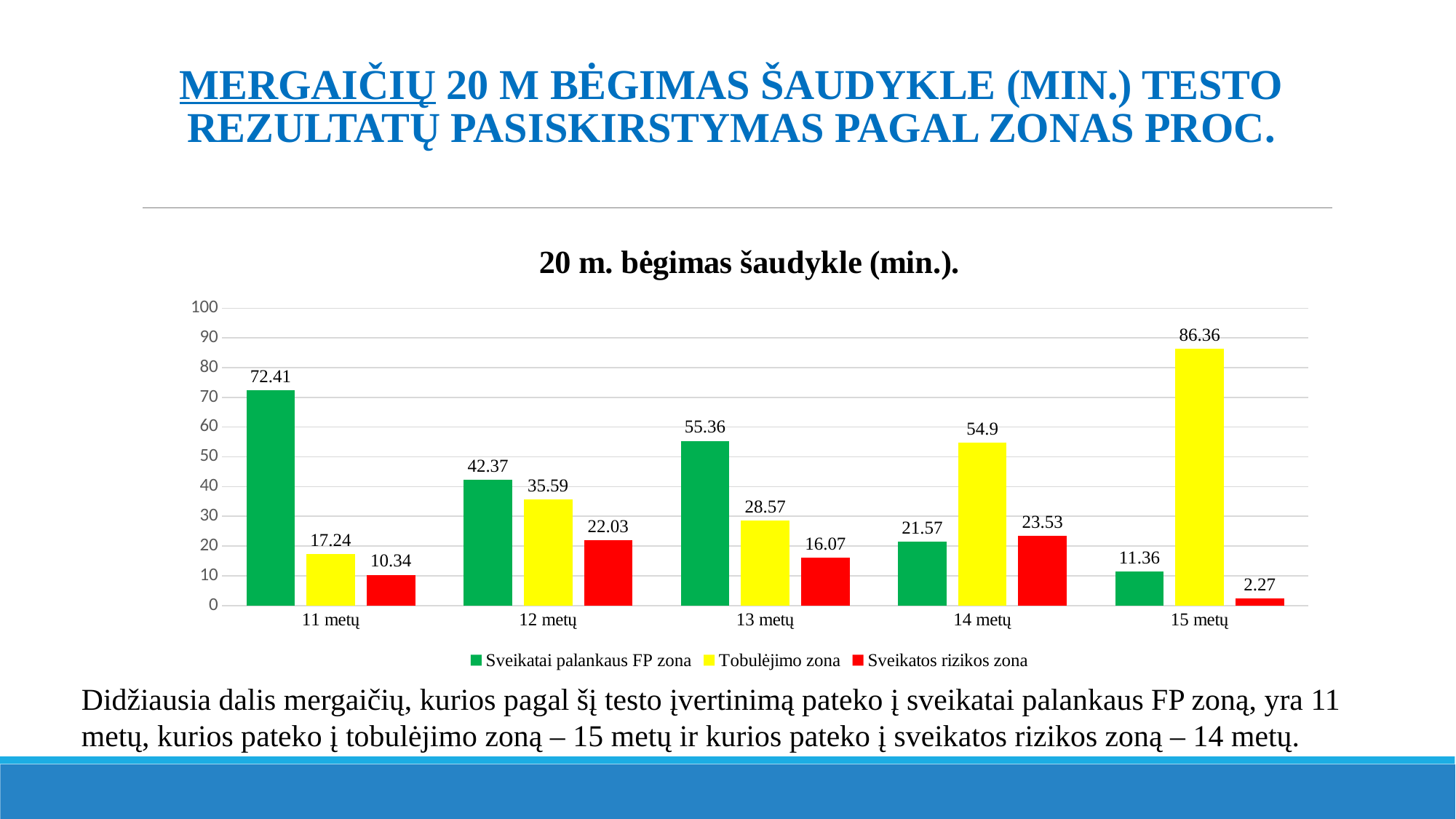
Which colour represents Sveikatos rizikos zona? red Is the value for Tobulėjimo zona at 13 metų greater or less than 30? less What is the difference between the Tobulėjimo zona values at 15 metų and 14 metų? 31.46 Which age group has the highest value for Sveikatos rizikos zona? 14 metų Which is larger at 12 metų: Sveikatai palankaus FP zona or Tobulėjimo zona? Sveikatai palankaus FP zona What kind of chart is shown? bar chart What is the value for Sveikatos rizikos zona at 13 metų? 16.07 What is the value for Sveikatai palankaus FP zona at 11 metų? 72.41 Which age group has the lowest value for Sveikatai palankaus FP zona? 15 metų How many series does the legend list? 3 How many age groups are shown on the x axis? 5 What is the value for Tobulėjimo zona at 15 metų? 86.36